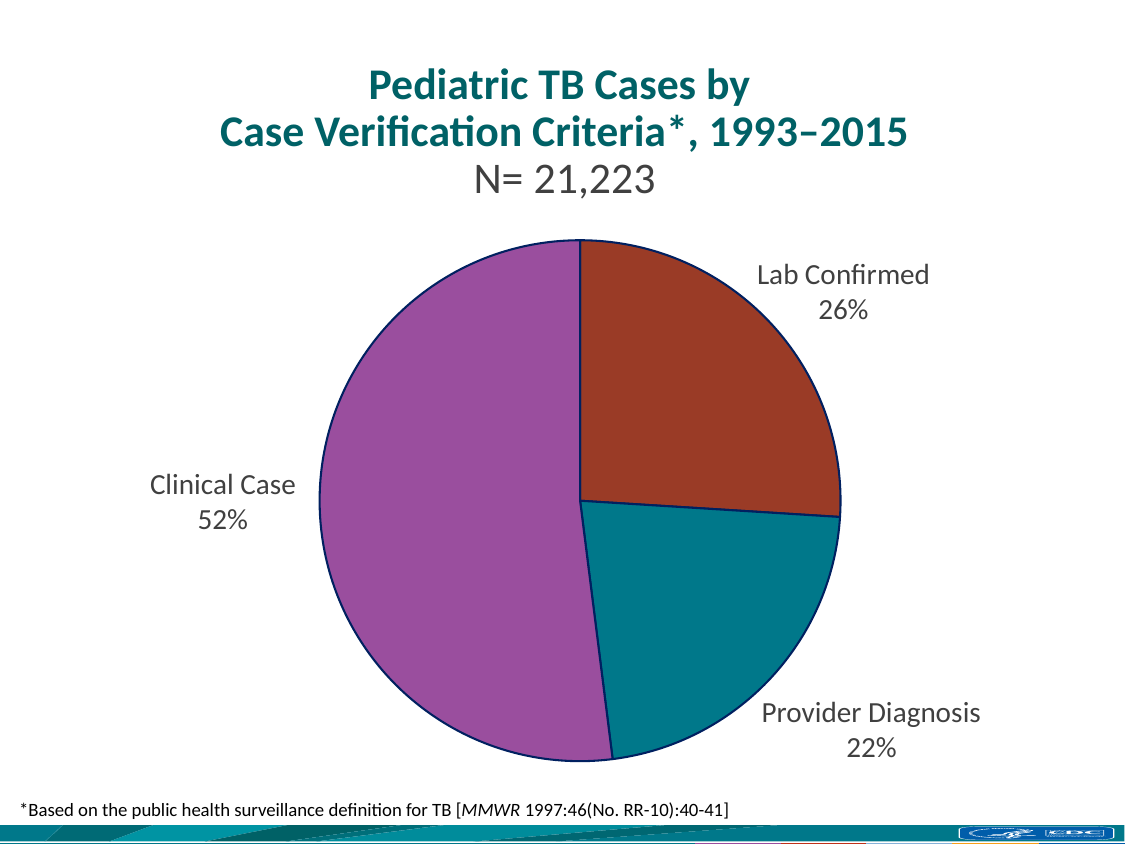
What share of pediatric TB cases were Lab Confirmed? 26% What is the total number of cases (N) stated on the slide? 21,223 What colour is the Clinical Case slice? purple What kind of chart is shown on the slide? pie chart What share of pediatric TB cases were Clinical Case? 52% Which case verification category has the largest share of the pie? Clinical Case What is the difference in percentage points between Lab Confirmed and Provider Diagnosis? 4 What share of pediatric TB cases were Provider Diagnosis? 22% Which is larger, the share for Lab Confirmed or the share for Provider Diagnosis? Lab Confirmed How many slices does the pie chart have? 3 Which case verification category has the smallest share of the pie? Provider Diagnosis What is the difference in percentage points between Clinical Case and Lab Confirmed? 26